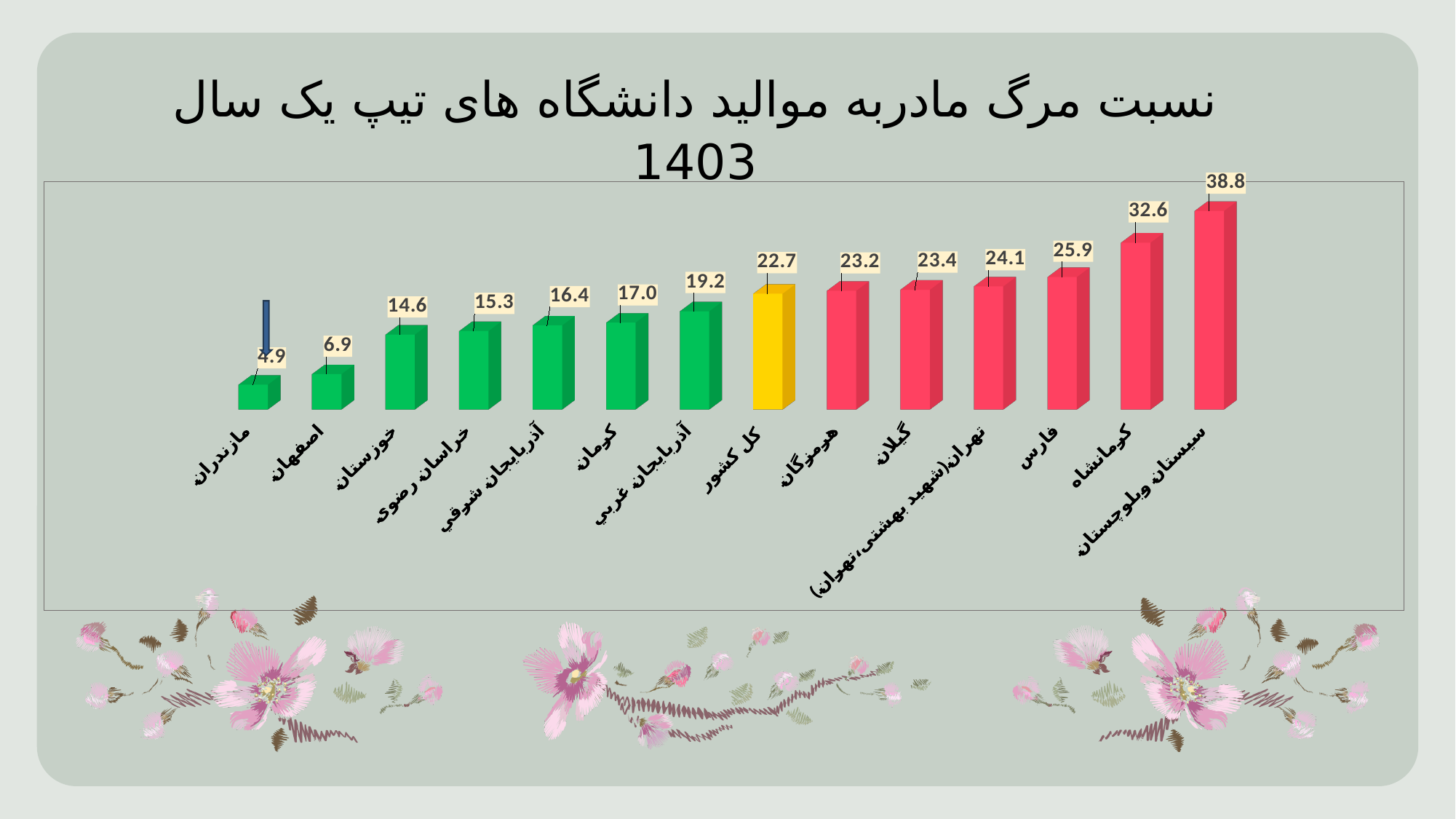
How many categories are shown in the chart? 14 What is the value shown for خوزستان? 14.6 What colour is the bar for کل کشور? Yellow What is the difference between the values for کرمانشاه and کل کشور? 9.9 Which has a larger value, کرمان or هرمزگان? هرمزگان What is the value shown for سیستان وبلوچستان? 38.8 What kind of chart is shown on the slide? Bar chart Which category has the lowest value? مازندران What is the value shown for فارس? 25.9 Which category has the highest value? سیستان وبلوچستان What is the difference between the values for اصفهان and مازندران? 2.0 What is the value shown for کل کشور? 22.7